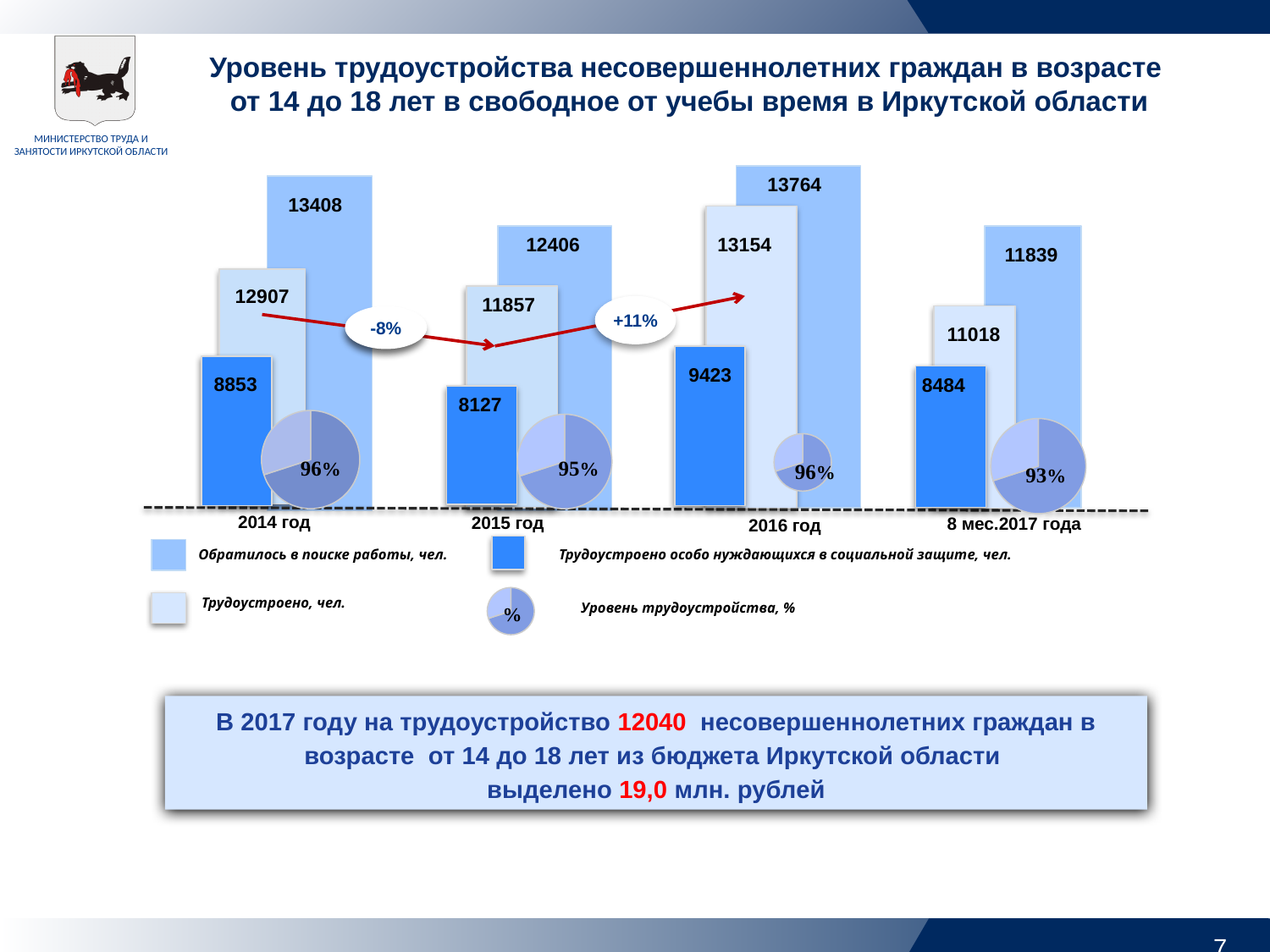
What is the value of "Трудоустроено особо нуждающихся в социальной защите, чел." for 2014 год? 8853 How many time periods are shown on the x axis of the chart? 4 What is the value of "Обратилось в поиске работы, чел." for 2016 год? 13764 How many entries does the chart legend list? 4 What type of chart is used to show the number of people who applied and were employed? Bar chart What is the difference between "Обратилось в поиске работы, чел." and "Трудоустроено, чел." in 2014 год? 501 In which period is the value of "Трудоустроено особо нуждающихся в социальной защите, чел." the lowest? 2015 год What is the value of "Трудоустроено, чел." for 2015 год? 11857 In which period is the value of "Обратилось в поиске работы, чел." the highest? 2016 год What percentage change is labelled on the arrow between 2014 год and 2015 год? -8% Which is larger: "Трудоустроено, чел." in 2016 год or in 8 мес.2017 года? 2016 год What is the "Уровень трудоустройства, %" shown for 8 мес.2017 года? 93%